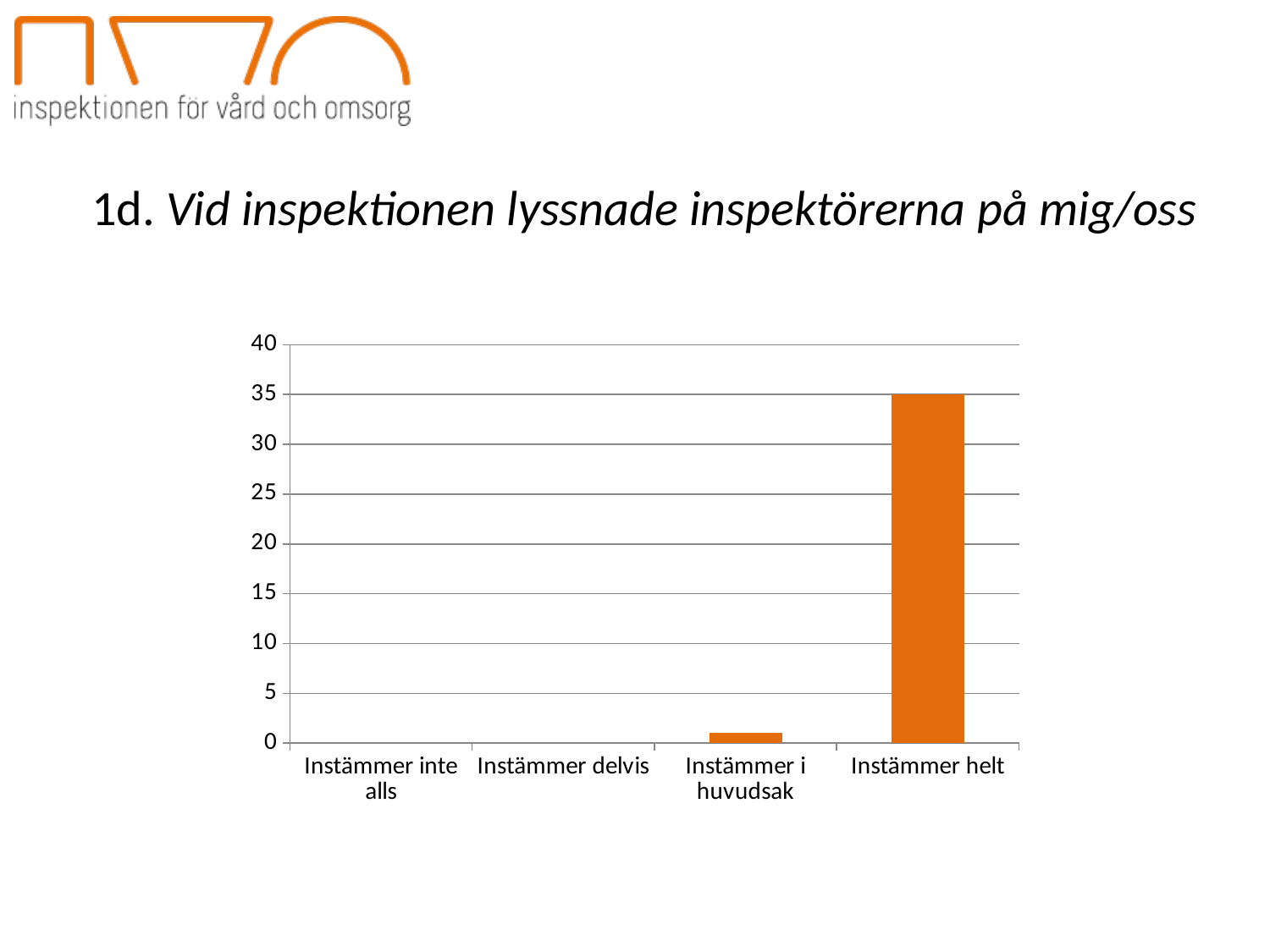
What kind of chart is shown on the slide? bar chart What colour are the bars in the chart? orange What is the value for Instämmer inte alls? 0 What is the title of the slide above the chart? 1d. Vid inspektionen lyssnade inspektörerna på mig/oss Which is larger, the value for Instämmer helt or the value for Instämmer i huvudsak? Instämmer helt What is the value for Instämmer helt? 35 Is the value for Instämmer i huvudsak greater or less than 5? less Do the values rise or fall from left to right along the x axis? rise Is the value for Instämmer helt greater or less than 30? greater How many categories have no visible bar in the chart? 2 Which category has the highest value in the chart? Instämmer helt How many categories are shown on the x axis of the chart? 4